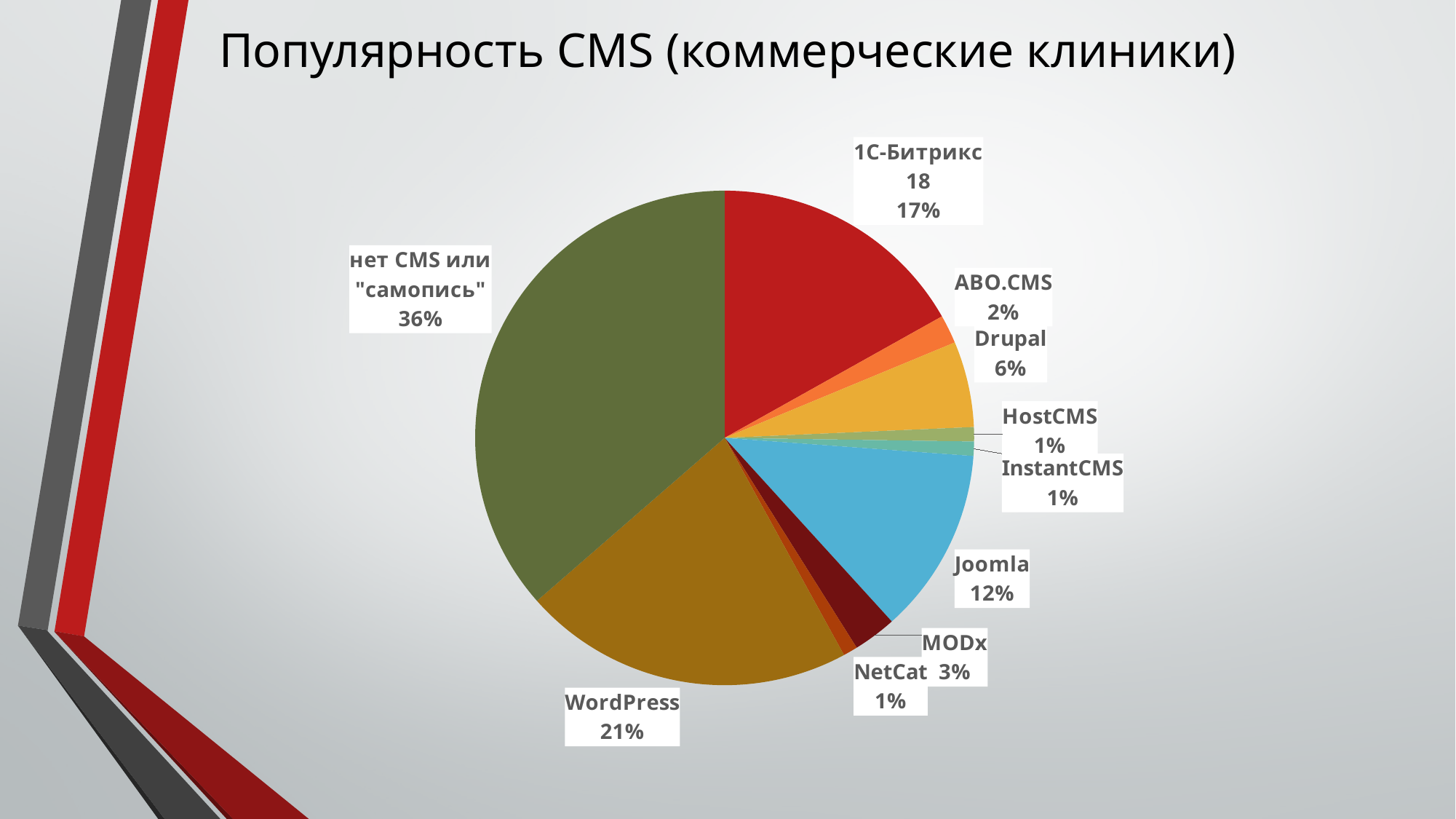
How many categories (slices) does the pie chart have? 10 Which category has the largest slice of the pie? нет CMS или "самопись" What count value is printed for the 1С-Битрикс slice? 18 What share of the pie does WordPress have? 21% What share of the pie does Joomla have? 12% What is the title of the chart? Популярность CMS (коммерческие клиники) What kind of chart is shown on the slide? pie chart What share of the pie does 1С-Битрикс have? 17% Which is larger, the share for WordPress or the share for Joomla? WordPress What is the difference in percentage points between the share for нет CMS или "самопись" and the share for WordPress? 15